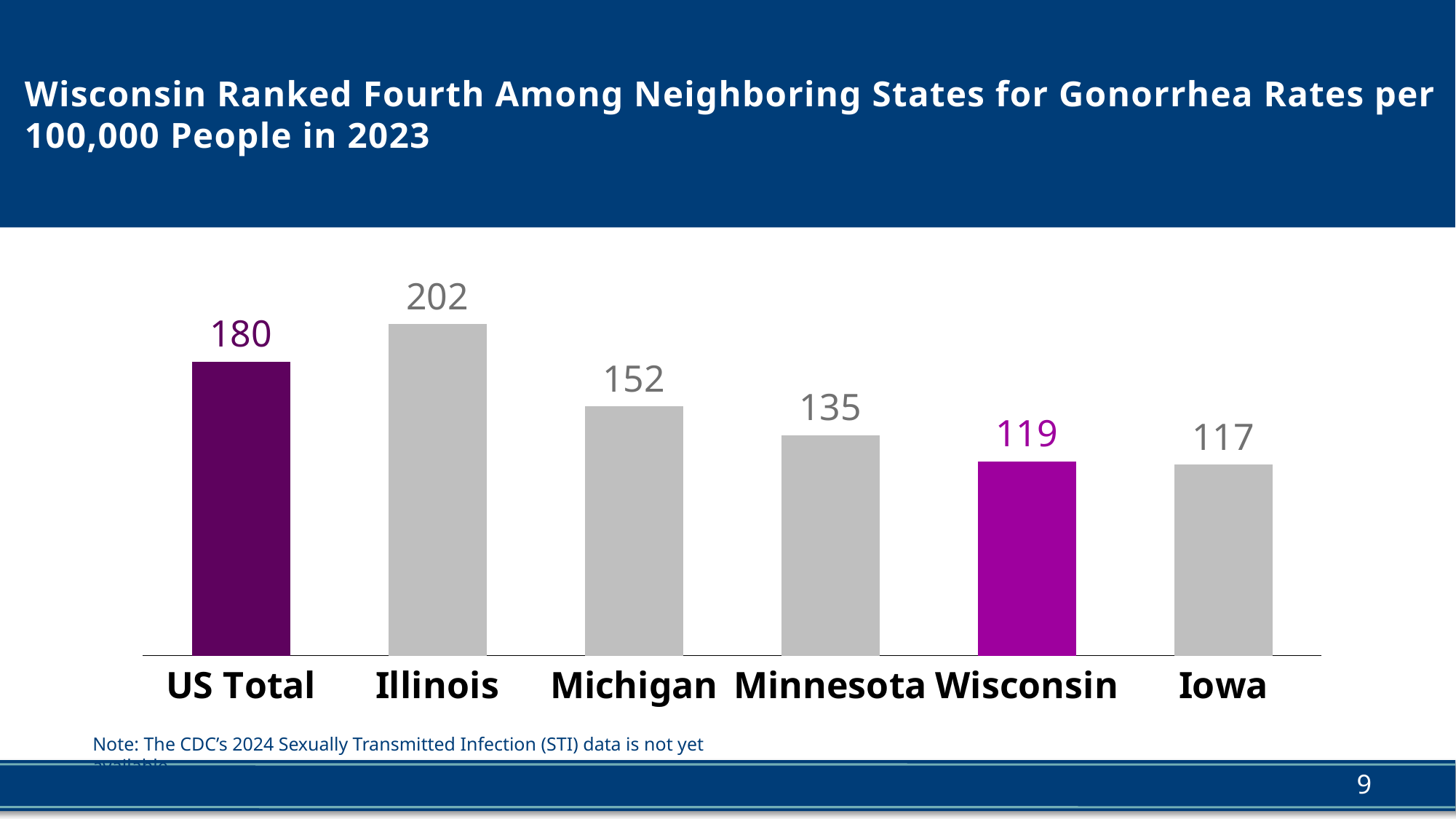
Which has a larger value, Michigan or Minnesota? Michigan How many bars are shown in the chart? 6 Which category has the lowest value in the chart? Iowa Which category has the highest value in the chart? Illinois What value is shown for the US Total bar? 180 Which has a larger value, US Total or Illinois? Illinois What type of chart is shown on the slide? Bar chart What is the gonorrhea rate per 100,000 people shown for Wisconsin? 119 What is the value shown for Michigan? 152 What is the difference between the Illinois value and the Wisconsin value? 83 Which bar is colored magenta to highlight it? Wisconsin What is the difference between the US Total value and the Minnesota value? 45